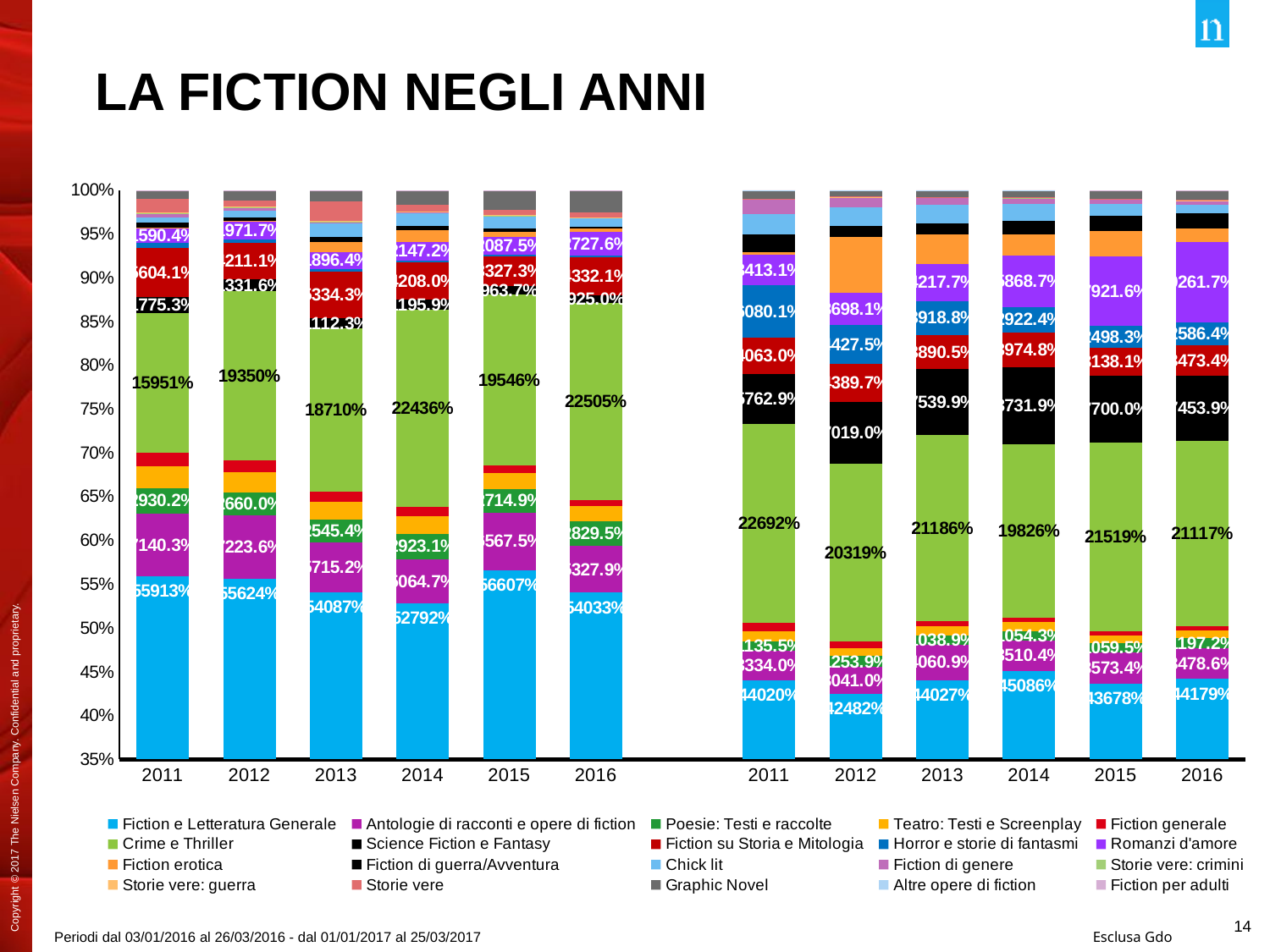
In the left chart, do the Fiction e Letteratura Generale values rise or fall from 2011 to 2014? Fall In the left chart, what is the labelled value of the Crime e Thriller segment for 2014? 22436% In the left chart, which year has the highest labelled value for Crime e Thriller? 2016 In the right chart, what is the labelled value of the Crime e Thriller segment for 2011? 22692% In the right chart, what is the difference between the Fiction e Letteratura Generale values for 2011 and 2012? 1538% How many series does the legend list? 20 In the right chart, what is the labelled value of the Fiction e Letteratura Generale segment for 2014? 45086% In the left chart, is the Fiction e Letteratura Generale value larger in 2014 or in 2015? 2015 In the right chart, which year has the lowest labelled value for Crime e Thriller? 2014 In the left chart, what is the difference between the Crime e Thriller values for 2012 and 2011? 3399% What kind of chart is the left chart? Stacked bar chart How many years are shown on the x axis of the left chart? 6